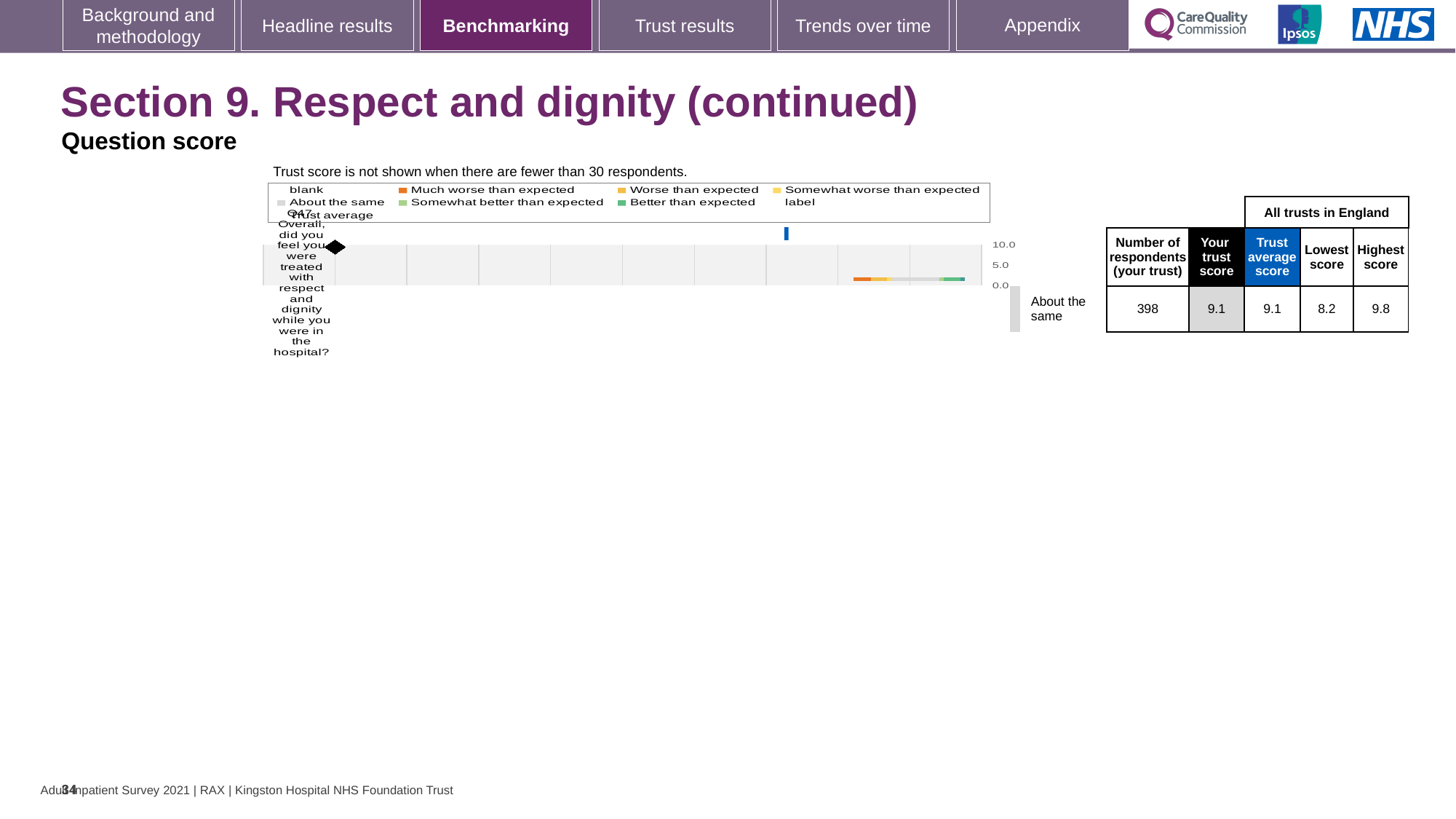
What is the trust score for Q47 (Overall, did you feel you were treated with respect and dignity while you were in the hospital?)? 9.1 What is the difference between the highest score and the trust score for Q47? 0.7 What kind of chart is used to show the Q47 benchmarking result? bar chart Which benchmark category is Q47 assigned to on the chart? About the same How many survey questions are plotted on the chart? 1 What is the difference between the highest score and the lowest score for Q47? 1.6 What is the lowest score among all trusts in England for Q47? 8.2 What is the trust average score for Q47? 9.1 How many respondents from the trust answered Q47? 398 What is the highest score among all trusts in England for Q47? 9.8 Is the trust score for Q47 greater or less than 5.0 on the chart's axis? greater What is the highest tick value shown on the chart's score axis? 10.0